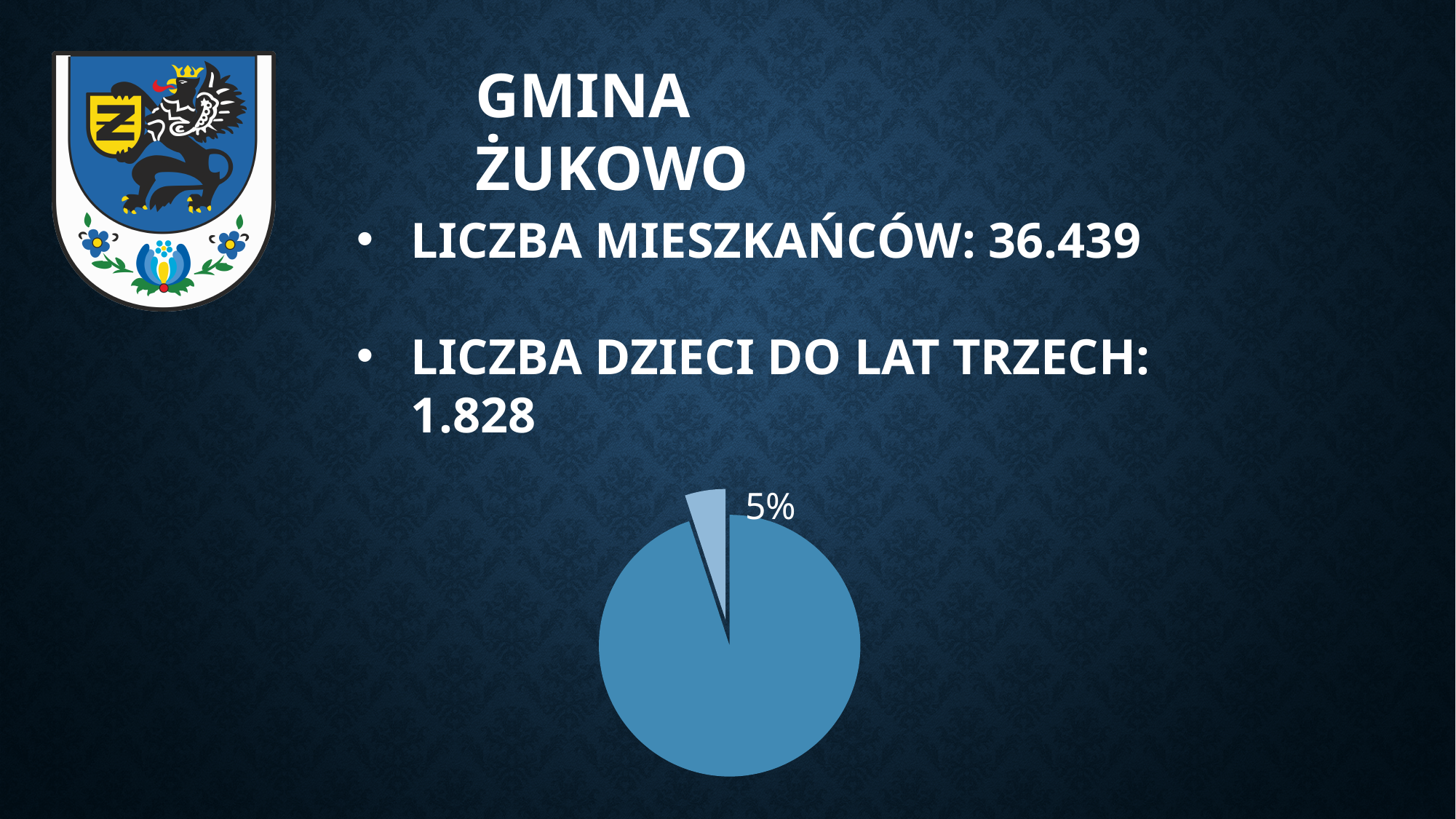
What colour is the slice of the pie chart that carries the 5% label? light blue Which slice of the pie chart is larger, the light-blue slice or the dark-blue slice? the dark-blue slice Which slice of the pie chart is the smallest? the light-blue slice labelled 5% How many slices does the pie chart have? 2 What kind of chart is shown on the slide? pie chart Does the pie chart have a legend? No What percentage is printed on the small light-blue slice of the pie chart? 5%